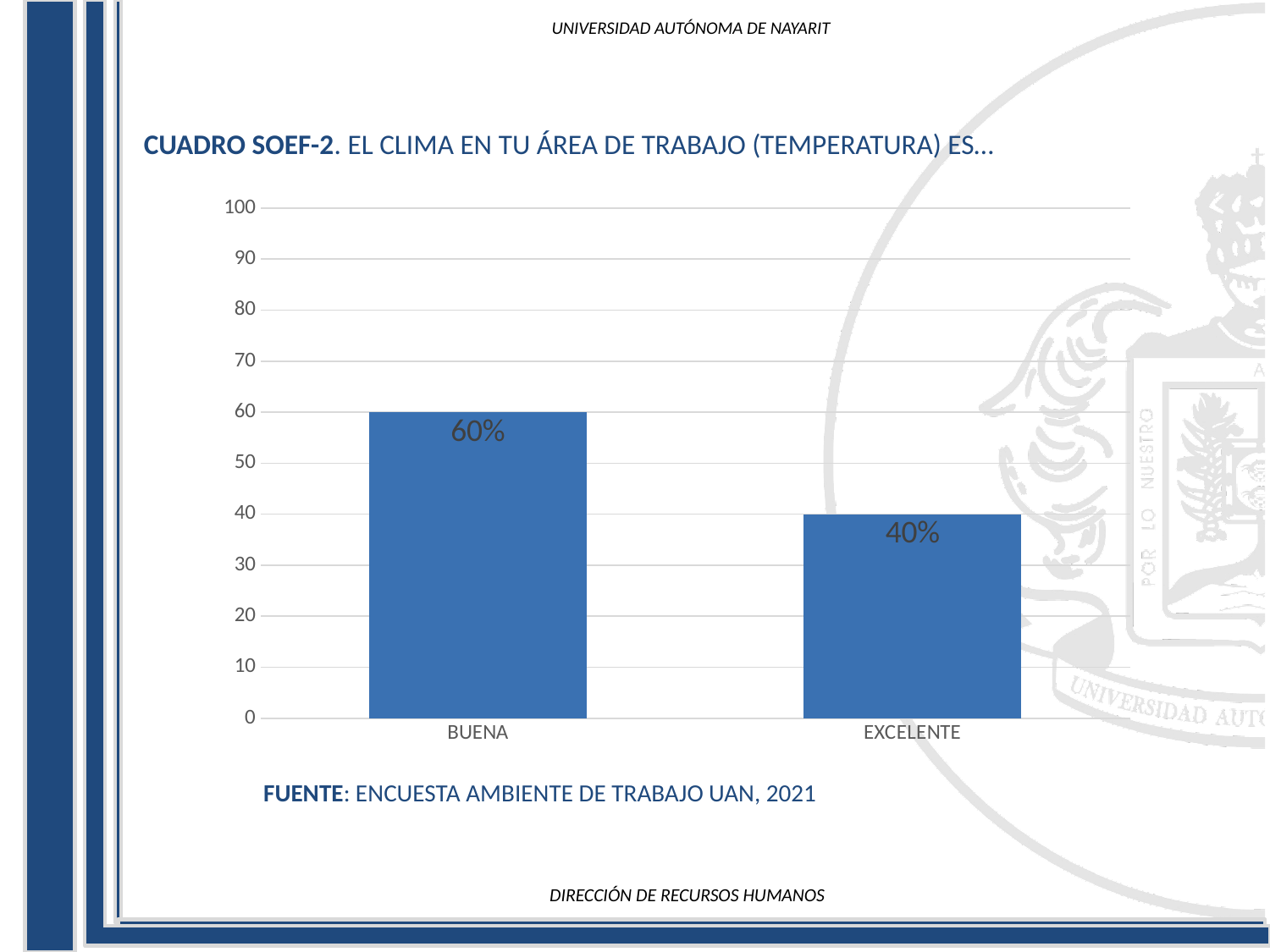
Is the value for EXCELENTE greater or less than 50? less How many categories are shown on the x axis? 2 What is the value for EXCELENTE? 40% What is the maximum value shown on the vertical axis? 100 Which category has the highest value? BUENA What is the value for BUENA? 60% Which category has the lowest value? EXCELENTE What source is cited below the chart? ENCUESTA AMBIENTE DE TRABAJO UAN, 2021 Is the value for BUENA greater or less than 50? greater What is the difference between the values for BUENA and EXCELENTE? 20% Which is larger, the value for BUENA or the value for EXCELENTE? BUENA What kind of chart is shown on the slide? bar chart